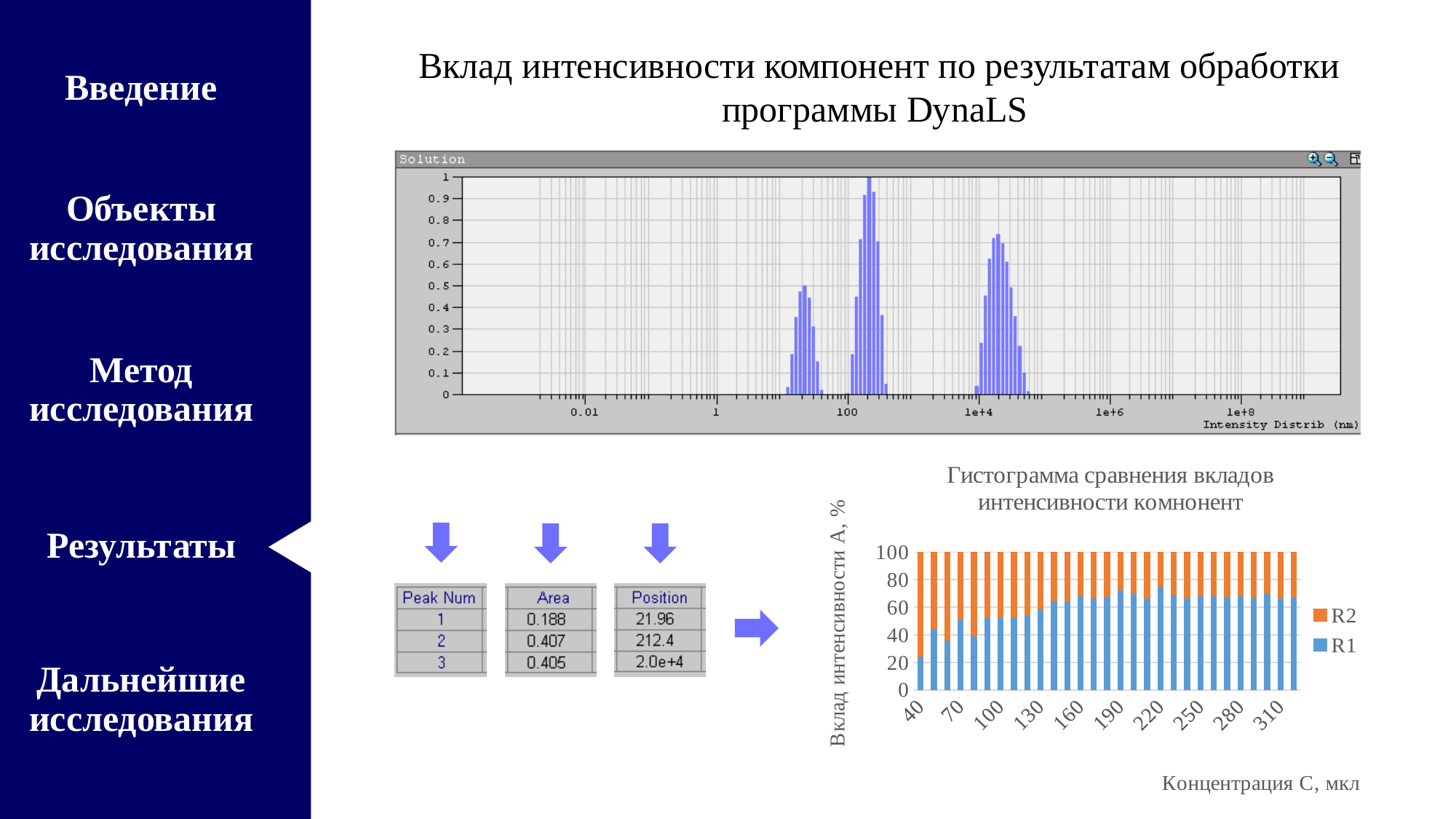
In the chart titled 'Гистограмма сравнения вкладов интенсивности компонент', how many series does the legend list? 2 In the chart titled 'Гистограмма сравнения вкладов интенсивности компонент', which series is larger at concentration 40, R1 or R2? R2 In the 'Solution' intensity distribution chart at the top of the slide, which peak is the tallest: the one near 10 nm, the one near 100–1000 nm, or the one near 1e+4 nm? The one near 100–1000 nm In the chart titled 'Гистограмма сравнения вкладов интенсивности компонент', is the R1 value at concentration 220 greater or less than 60? greater In the chart titled 'Гистограмма сравнения вкладов интенсивности компонент', what are the names of the series in the legend? R2 and R1 In the chart titled 'Гистограмма сравнения вкладов интенсивности компонент', does the R1 share generally rise or fall as concentration increases along the x axis? rise In the 'Solution' intensity distribution chart at the top of the slide, what is the maximum value shown on the vertical axis? 1 In the 'Solution' intensity distribution chart at the top of the slide, how many separate peaks are shown? 3 What kind of chart is the 'Гистограмма сравнения вкладов интенсивности компонент' chart? Stacked bar chart In the chart titled 'Гистограмма сравнения вкладов интенсивности компонент', what is the label of the vertical axis? Вклад интенсивности A, % In the chart titled 'Гистограмма сравнения вкладов интенсивности компонент', is the R1 value at concentration 40 greater or less than 40? less